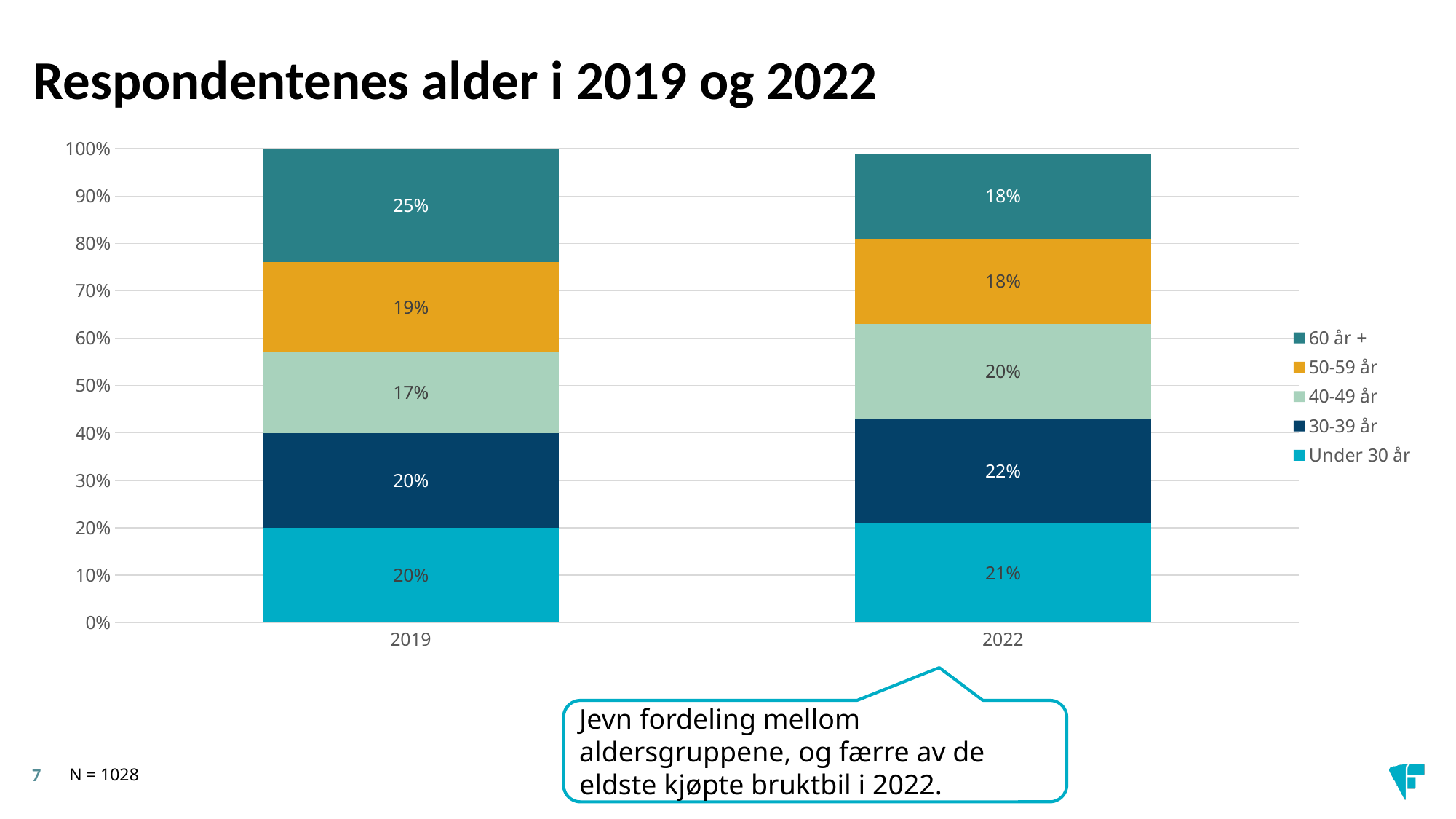
What kind of chart is shown on the slide? Stacked bar chart Which age group had the largest share in 2019? 60 år + How many age groups does the legend list? 5 What share of respondents were 40-49 år in 2019? 17% What share of respondents were 60 år + in 2019? 25% Did the share of 60 år + rise or fall from 2019 to 2022? Fall What share of respondents were 30-39 år in 2022? 22% Which age group had the smallest share in 2019? 40-49 år By how many percentage points did the share of 60 år + fall from 2019 to 2022? 7 percentage points Was the share of 40-49 år larger in 2019 or in 2022? 2022 What share of respondents were 50-59 år in 2022? 18% How many years are shown on the x axis? 2